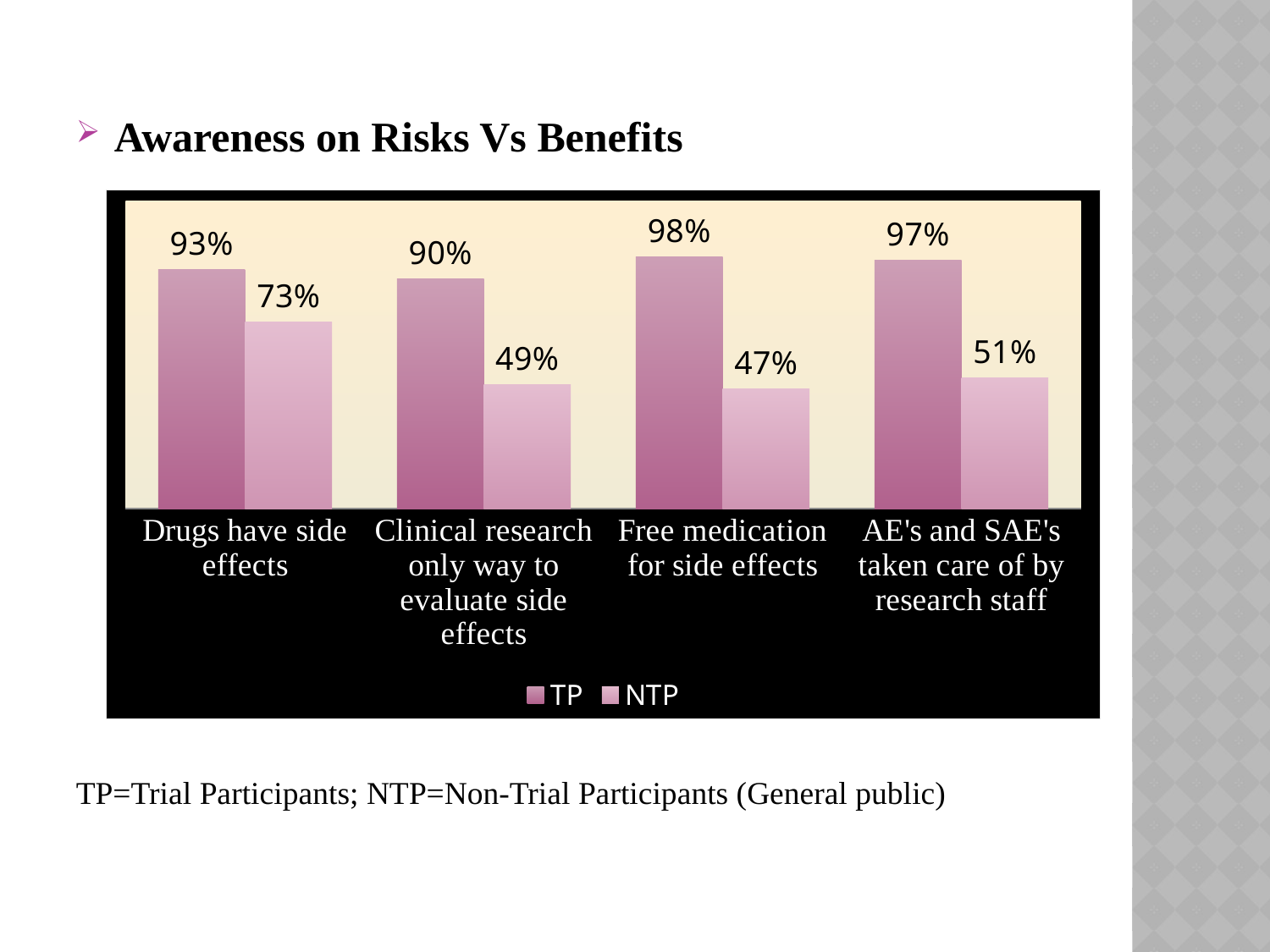
Which is larger: the NTP value for "Drugs have side effects" or the NTP value for "AE's and SAE's taken care of by research staff"? Drugs have side effects What is the difference between the TP and NTP values for "Drugs have side effects"? 20% What is the difference between the TP and NTP values for "Clinical research only way to evaluate side effects"? 41% Which category has the lowest NTP value? Free medication for side effects Which category has the highest TP value? Free medication for side effects How many categories are shown on the x axis? 4 What is the NTP value for "AE's and SAE's taken care of by research staff"? 51% What are the two series named in the legend? TP and NTP How many series does the legend list? 2 What is the NTP value for "Free medication for side effects"? 47% What is the TP value for "Drugs have side effects"? 93% What kind of chart is shown on the slide? Bar chart